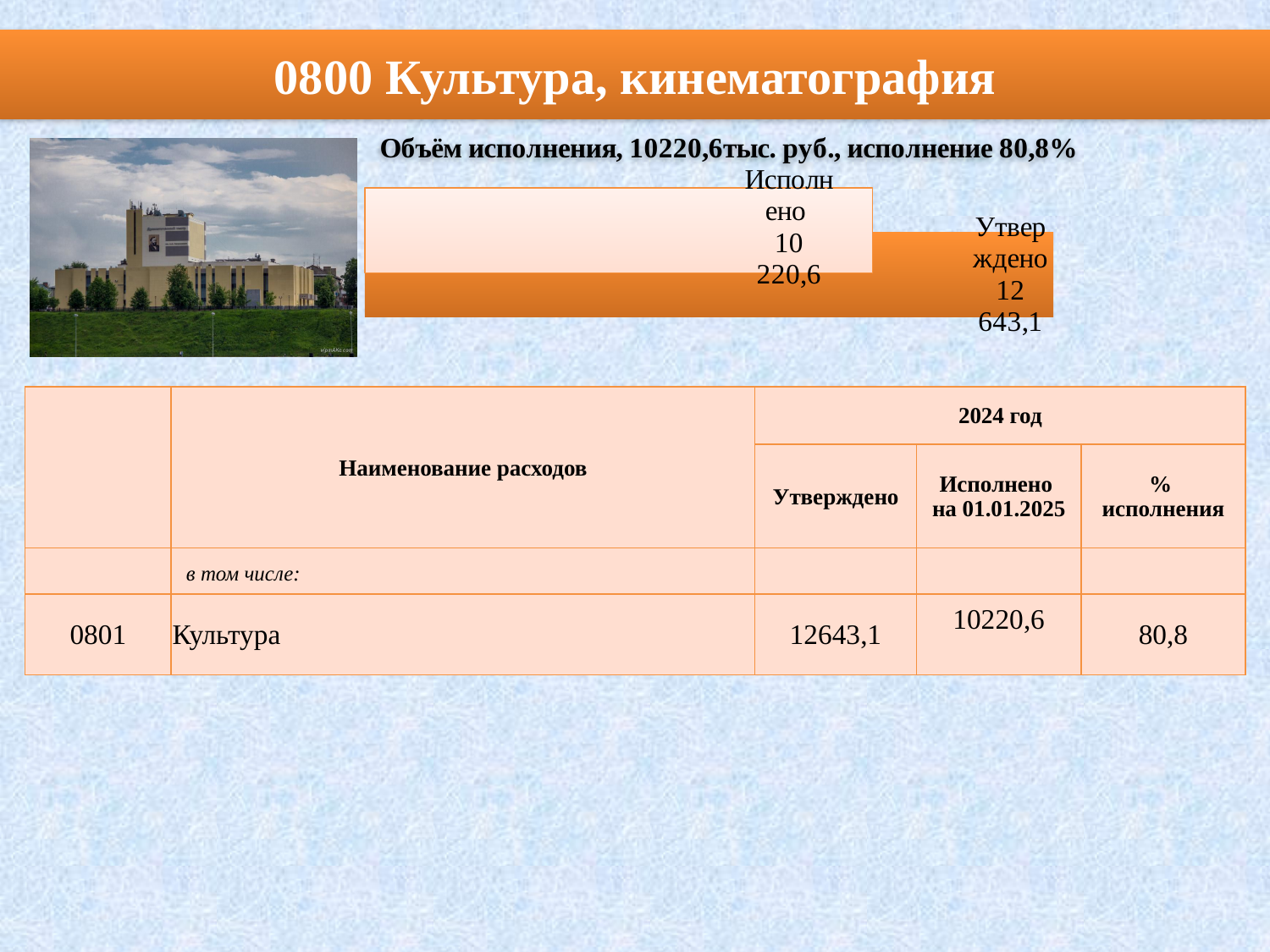
What colour is the Утверждено bar in the chart? Orange Which category in the bar chart has the lowest value? Исполнено Are the bars in the chart horizontal or vertical? Horizontal Which category in the bar chart has the highest value? Утверждено What value is shown for Утверждено in the bar chart? 12 643,1 What kind of chart is shown on the slide? Bar chart How many bars are plotted in the chart? 2 Which bar in the chart has the higher value, Исполнено or Утверждено? Утверждено What is the difference between the Утверждено and Исполнено values in the bar chart? 2 422,5 What value is shown for Исполнено in the bar chart? 10 220,6